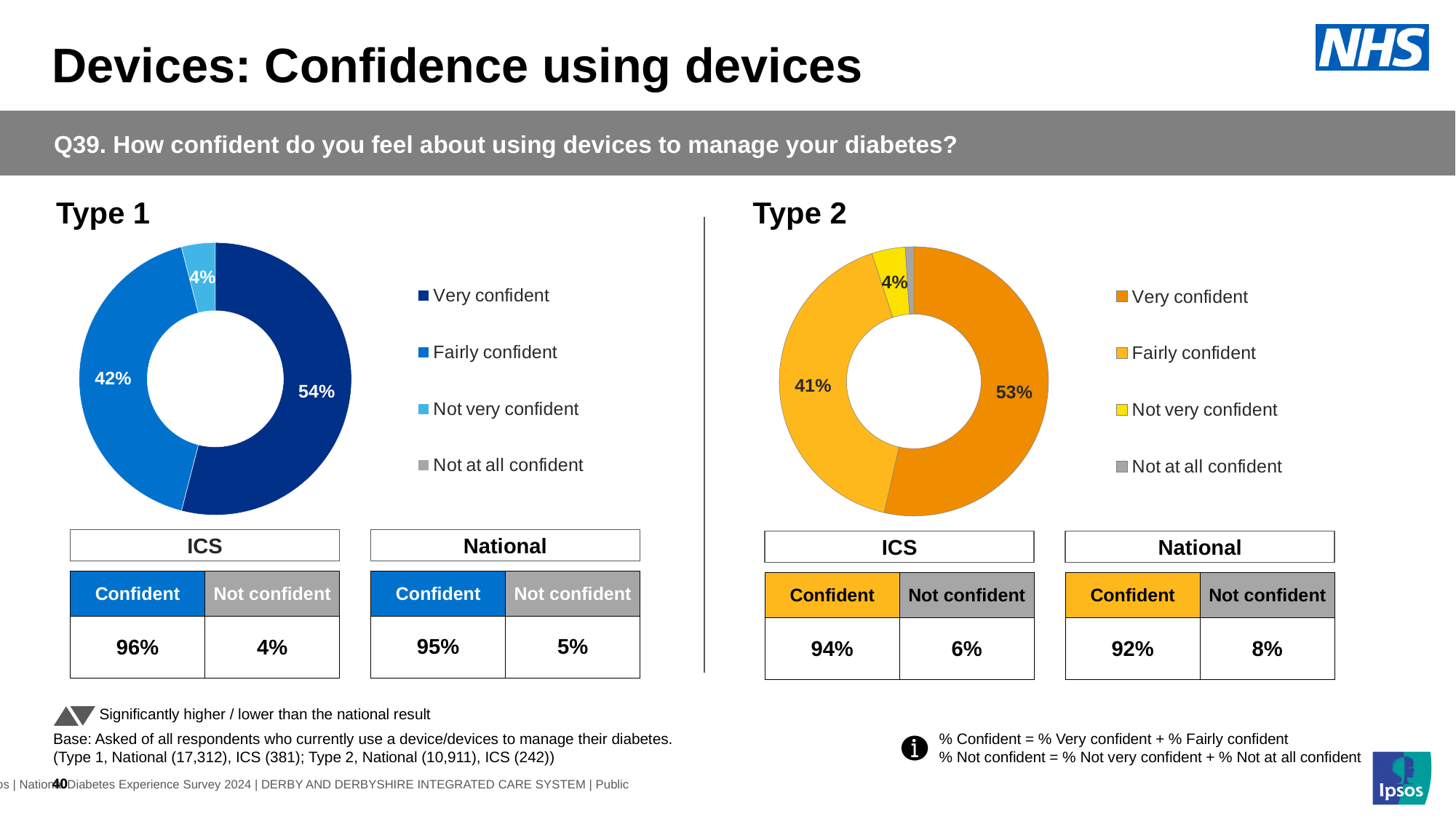
In the Type 2 chart, which category has the largest share? Very confident In the Type 1 chart, what is the difference between the very confident and fairly confident shares? 12 percentage points In the Type 2 chart, what percentage of respondents are fairly confident? 41% How many categories does the legend of the Type 2 chart list? 4 In the Type 2 chart, what percentage of respondents are very confident? 53% Which is larger: the very confident share in the Type 1 chart or the very confident share in the Type 2 chart? Type 1 In the Type 1 chart, what percentage of respondents are very confident? 54% In the Type 1 chart, what percentage of respondents are fairly confident? 42% In the Type 2 chart, what percentage of respondents are not very confident? 4% In the Type 1 chart, which category has the largest share? Very confident What type of chart is used for Type 1 and Type 2? Donut chart In the Type 2 chart, what is the difference between the very confident and fairly confident shares? 12 percentage points